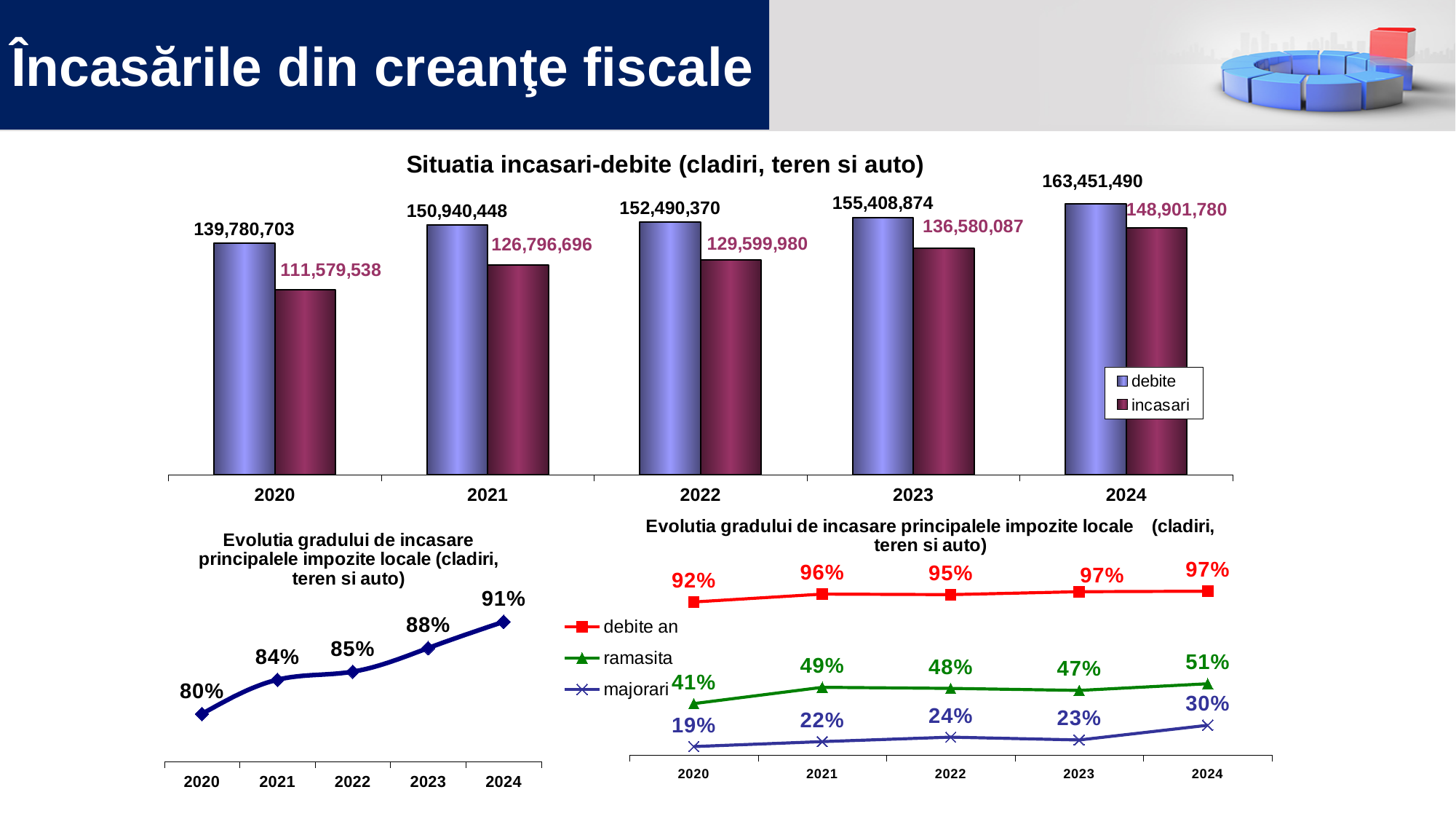
In the bottom-right line chart, what is the value of ramasita in 2024? 51% In the top bar chart 'Situatia incasari-debite', what is the incasari value for 2020? 111,579,538 In the bottom-right line chart, which year has the lowest majorari value? 2020 In the top bar chart 'Situatia incasari-debite', what is the difference between debite and incasari in 2023? 18,828,787 In the top bar chart 'Situatia incasari-debite', how many series does the legend list? 2 In the bottom-left line chart, how many years are plotted? 5 In the top bar chart 'Situatia incasari-debite', which year has the highest incasari value? 2024 In the bottom-left line chart, do the values rise or fall from 2020 to 2024? rise What kind of chart is the top chart 'Situatia incasari-debite'? bar chart In the top bar chart 'Situatia incasari-debite', what is the debite value for 2022? 152,490,370 In the bottom-right line chart, how many series does the legend list? 3 In the bottom-left line chart, what is the value for 2021? 84%